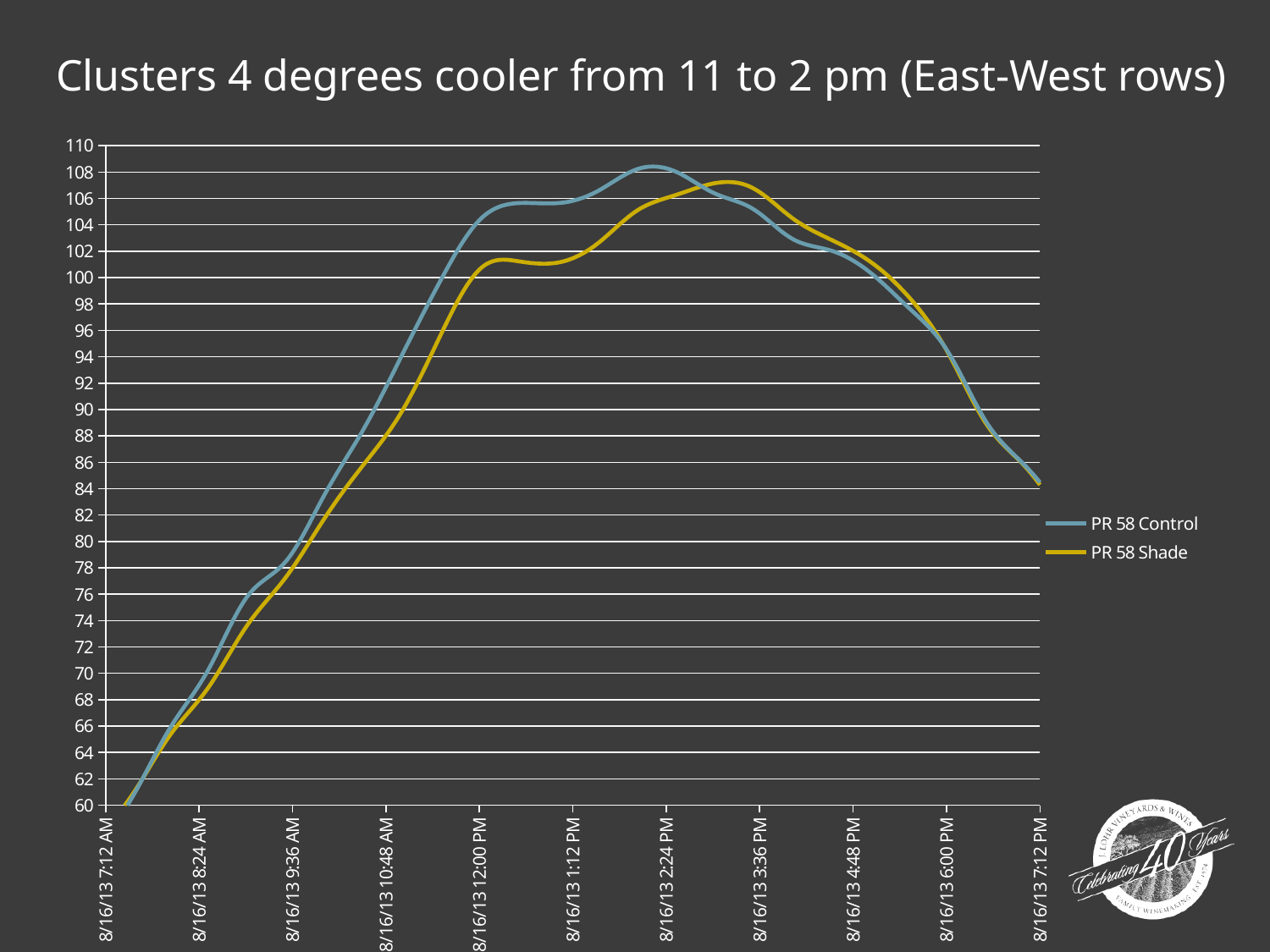
How many series does the legend list? 2 At 8/16/13 2:24 PM, which series has the higher value, PR 58 Control or PR 58 Shade? PR 58 Control Between 8/16/13 4:48 PM and 8/16/13 7:12 PM, do the values for PR 58 Control rise or fall? fall What are the two series named in the legend? PR 58 Control and PR 58 Shade Is the value for PR 58 Shade at 8/16/13 12:00 PM greater or less than 104? less Is the value for PR 58 Shade at 8/16/13 7:12 PM greater or less than 90? less Is the value for PR 58 Control at 8/16/13 12:00 PM greater or less than 100? greater What is the title of the chart slide? Clusters 4 degrees cooler from 11 to 2 pm (East-West rows) What kind of chart is shown on the slide? line chart Which series reaches the highest peak value on the chart? PR 58 Control At 8/16/13 3:36 PM, which series has the higher value, PR 58 Control or PR 58 Shade? PR 58 Shade